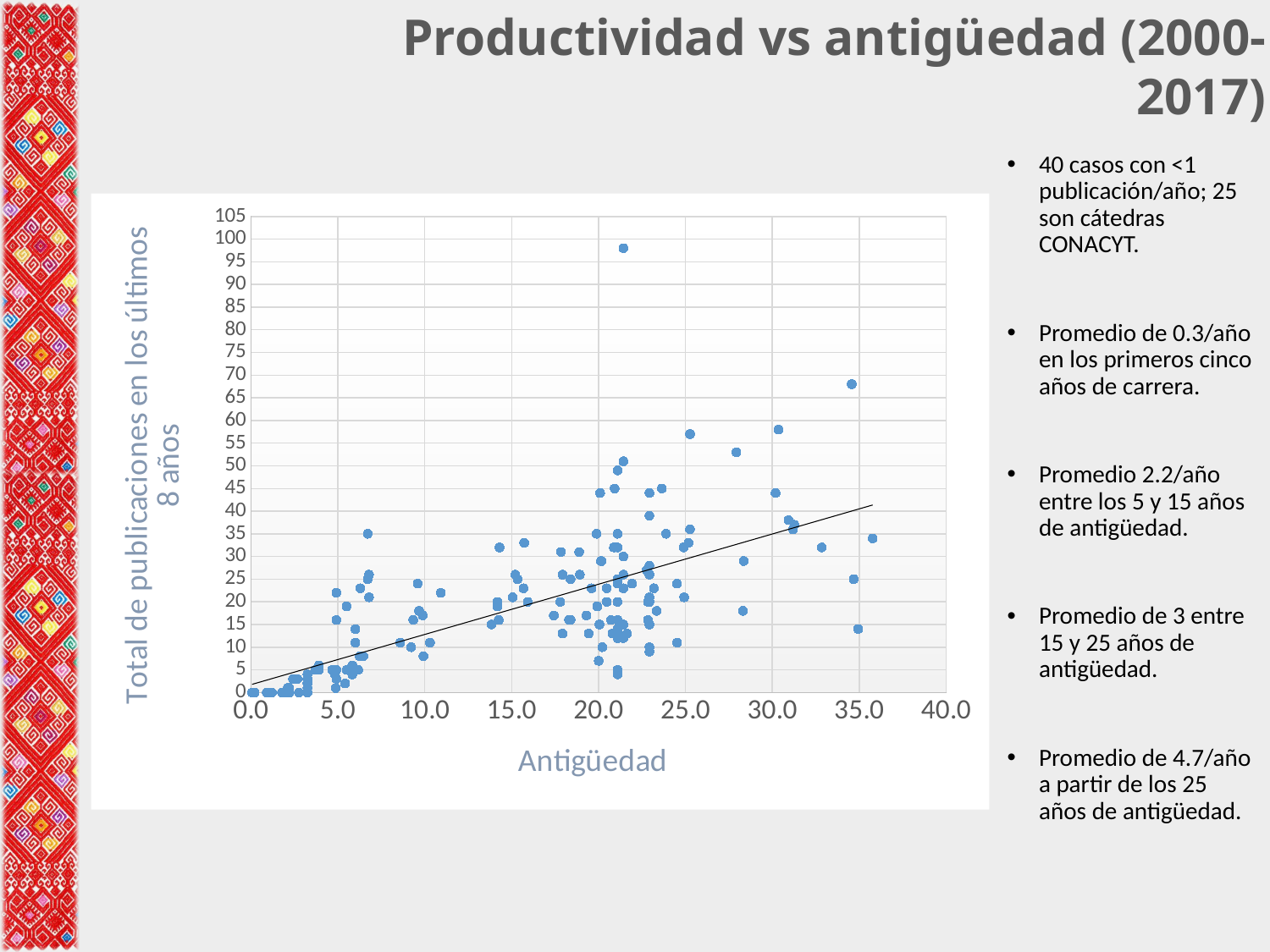
What is the label of the x axis of the chart? Antigüedad What is the maximum value shown on the x axis of the chart? 40.0 According to the trend line, do publications rise or fall as antigüedad increases? rise Is the point with the largest antigüedad (around 36 years) greater or less than 40 publications? less Is the point at roughly 34.5 years of antigüedad with the most publications greater or less than 60 publications? greater What is the title of the chart on the slide? Productividad vs antigüedad (2000-2017) Is the highest point at roughly 30 years of antigüedad greater or less than 50 publications? greater What kind of chart is shown on the slide? scatter plot